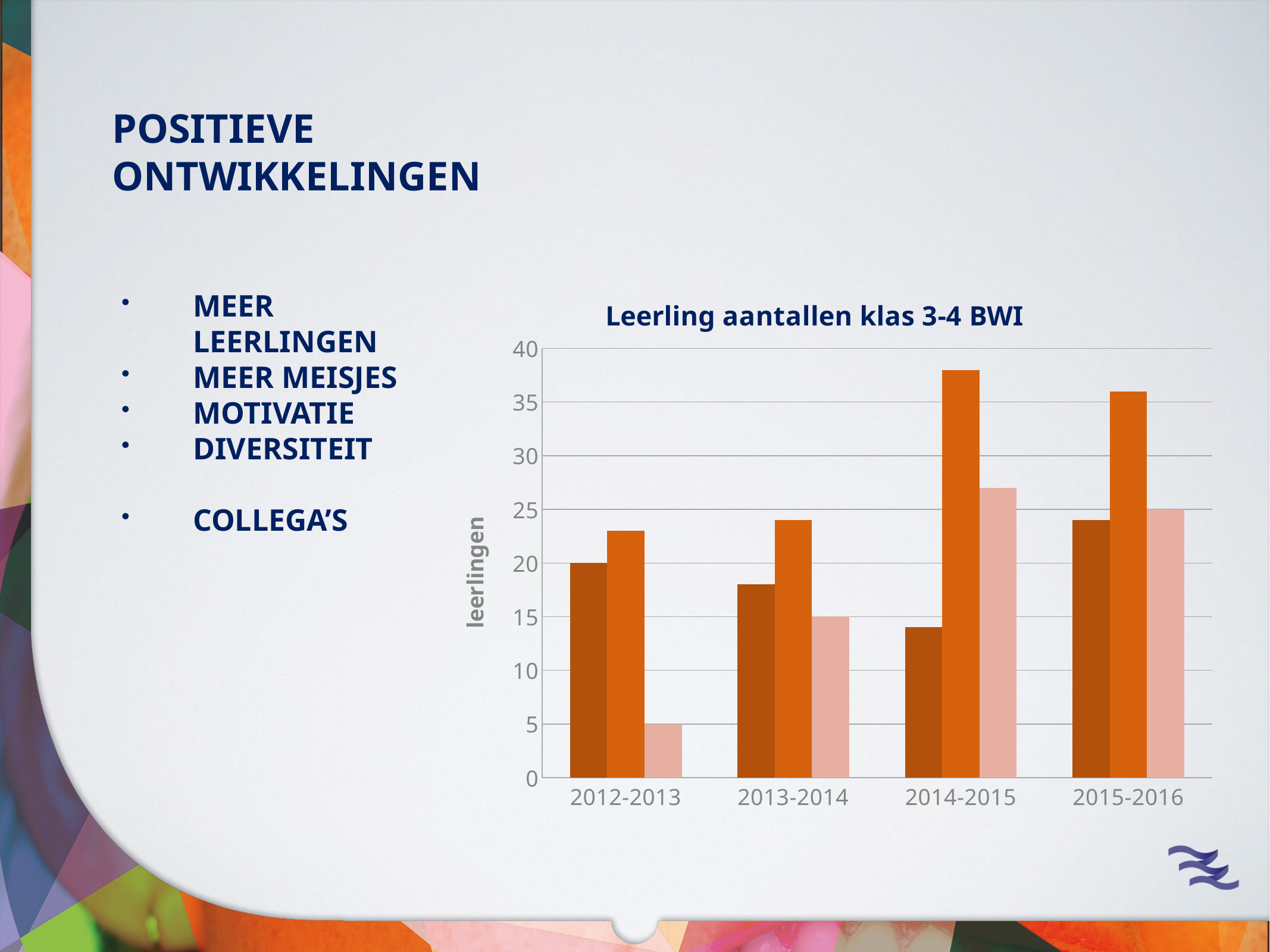
What is the value of the third (light pink) bar for 2012-2013? 5 Is the value of the first (dark orange) bar for 2014-2015 greater or less than 15? less Is the value of the second (orange) bar for 2014-2015 greater or less than 35? greater What is the label of the vertical axis of the chart? leerlingen How many school-year categories are shown on the x axis of the chart? 4 What is the value of the third (light pink) bar for 2013-2014? 15 What is the title of the chart? Leerling aantallen klas 3-4 BWI Does the third (light pink) bar rise or fall from 2012-2013 to 2014-2015? rise What is the value of the third (light pink) bar for 2015-2016? 25 What type of chart is shown on the slide? bar chart What is the value of the first (dark orange) bar for 2012-2013? 20 In which school year is the second (orange) bar the highest? 2014-2015